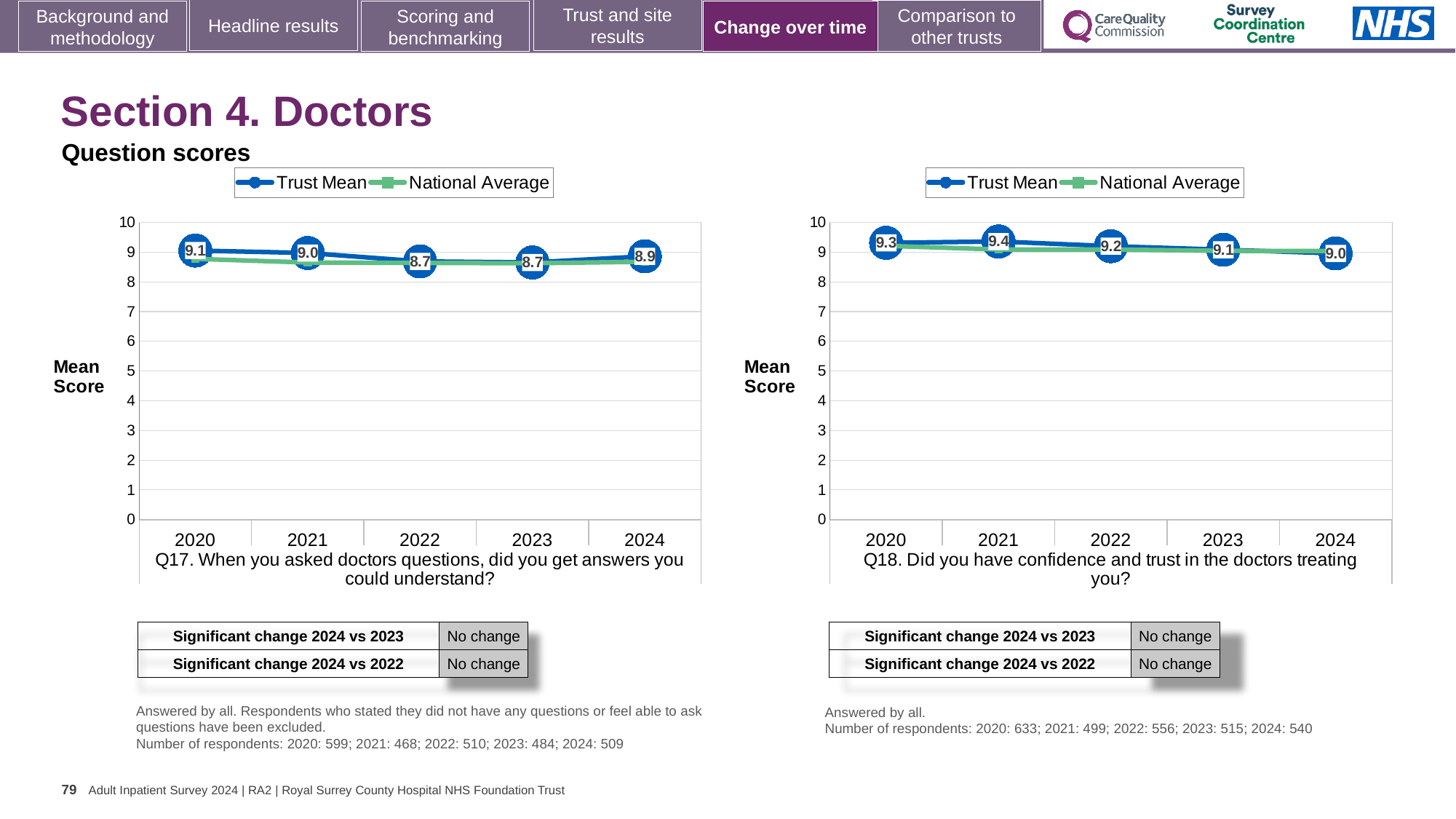
In the Q18 chart (right), what is the Trust Mean score for 2024? 9.0 In the Q17 chart (left), what is the difference between the Trust Mean scores for 2020 and 2022? 0.4 In the Q18 chart (right), what is the Trust Mean score for 2021? 9.4 In the Q17 chart (left), what is the Trust Mean score for 2024? 8.9 In the Q18 chart (right), what is the difference between the Trust Mean scores for 2021 and 2024? 0.4 How many years are plotted on the x axis of the Q18 chart (right)? 5 In the Q18 chart (right), which year has the lowest Trust Mean score? 2024 In the Q17 chart (left), is the Trust Mean score higher in 2021 or in 2024? 2021 In the Q17 chart (left), is the National Average value for 2022 greater or less than 8? greater How many series does the legend of the Q17 chart (left) list? 2 In the Q18 chart (right), which year has the highest Trust Mean score? 2021 In the Q17 chart (left), what is the Trust Mean score for 2020? 9.1